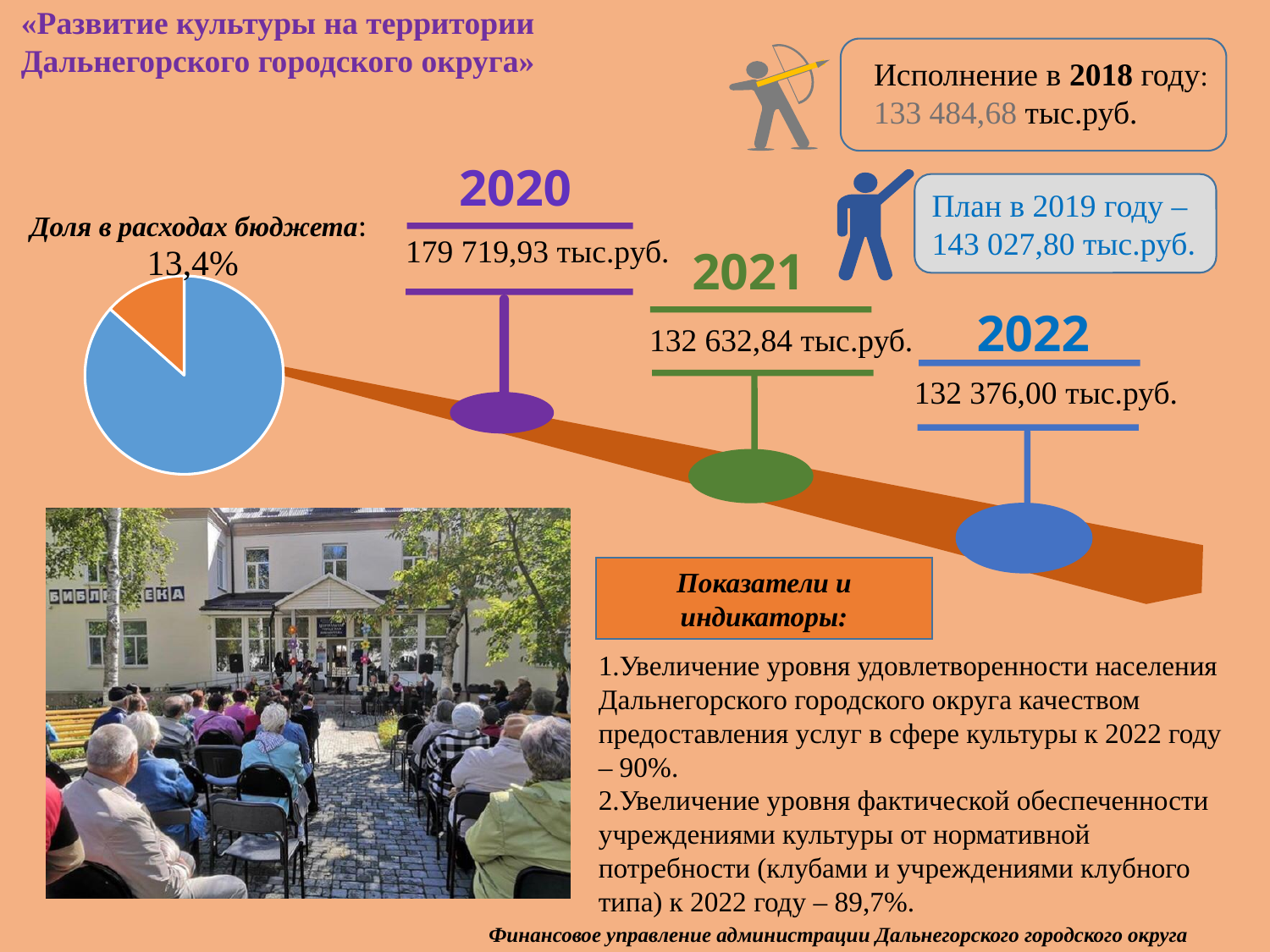
What kind of chart is shown under the heading «Доля в расходах бюджета»? pie chart On the timeline, which year has the lowest amount among 2020, 2021 and 2022? 2022 On the timeline, which year has the highest amount among 2020, 2021 and 2022? 2020 What colour is the slice labelled 13,4% in the pie chart? orange On the timeline, what amount is shown for 2022? 132 376,00 тыс.руб. What is the difference between the 2021 amount and the 2022 amount on the timeline? 256,84 тыс.руб. In the pie chart «Доля в расходах бюджета», is the orange slice's share greater or less than 25%? less On the timeline, what amount is shown for 2020? 179 719,93 тыс.руб. On the timeline, do the amounts rise or fall from 2020 to 2022? fall In the pie chart «Доля в расходах бюджета», what share is labelled on the orange slice? 13,4% In the pie chart «Доля в расходах бюджета», which slice is larger, the blue one or the orange one? the blue one How many slices does the pie chart «Доля в расходах бюджета» have? 2